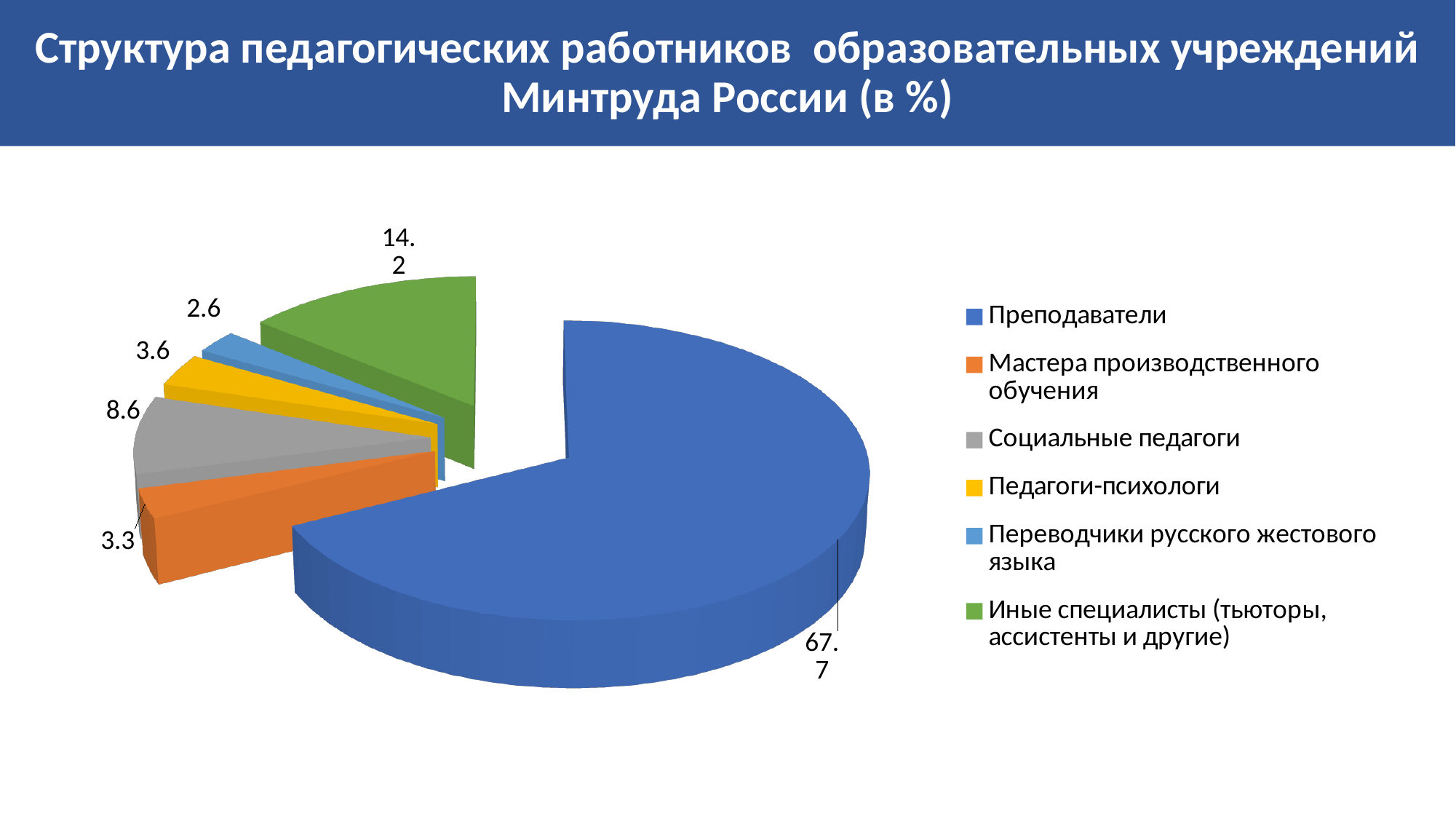
What is the value shown for Переводчики русского жестового языка? 2.6 What is the value shown for Социальные педагоги? 8.6 How many slices does the pie chart have? 6 Which category has the largest slice of the pie? Преподаватели What is the value shown for Преподаватели? 67.7 Which is larger, the value for Социальные педагоги or the value for Педагоги-психологи? Социальные педагоги What is the difference between the values for Преподаватели and Иные специалисты (тьюторы, ассистенты и другие)? 53.5 What is the value shown for Педагоги-психологи? 3.6 What kind of chart is shown on the slide? pie chart How many entries does the legend list? 6 Which category has the smallest slice of the pie? Переводчики русского жестового языка What is the value shown for Иные специалисты (тьюторы, ассистенты и другие)? 14.2